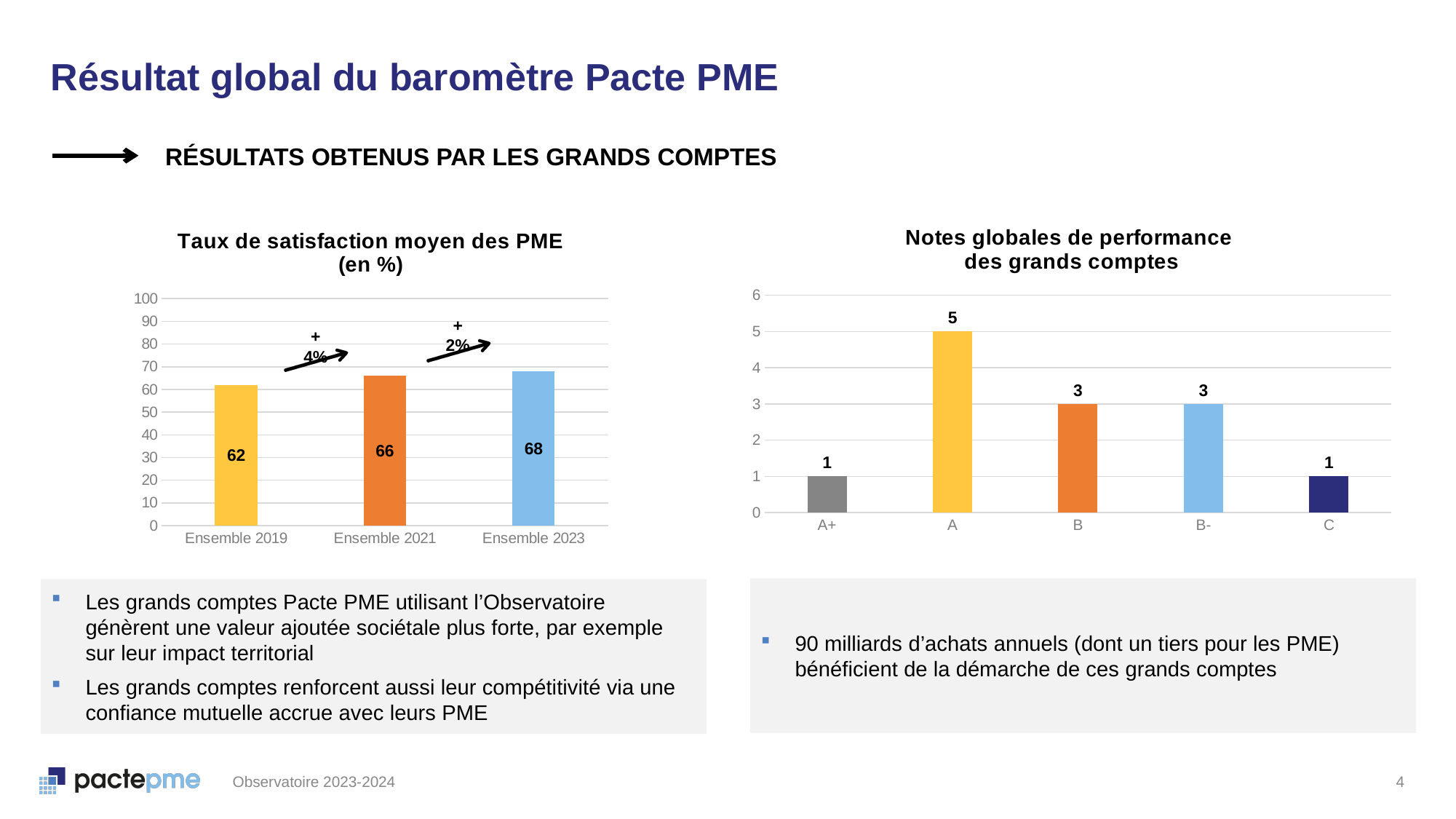
What kind of chart is 'Notes globales de performance des grands comptes'? bar chart In the chart 'Notes globales de performance des grands comptes', how many categories are shown? 5 In the chart 'Notes globales de performance des grands comptes', which is larger, the value for B or the value for C? B In the chart 'Notes globales de performance des grands comptes', what is the value for B-? 3 In the chart 'Taux de satisfaction moyen des PME (en %)', what is the difference between Ensemble 2023 and Ensemble 2019? 6 In the chart 'Taux de satisfaction moyen des PME (en %)', do the values rise or fall from Ensemble 2019 to Ensemble 2023? rise In the chart 'Notes globales de performance des grands comptes', what is the difference between the values for A and A+? 4 In the chart 'Notes globales de performance des grands comptes', what is the value for A? 5 In the chart 'Taux de satisfaction moyen des PME (en %)', how many categories are shown? 3 In the chart 'Taux de satisfaction moyen des PME (en %)', what is the value for Ensemble 2021? 66 In the chart 'Taux de satisfaction moyen des PME (en %)', which category has the highest value? Ensemble 2023 In the chart 'Notes globales de performance des grands comptes', which category has the highest value? A